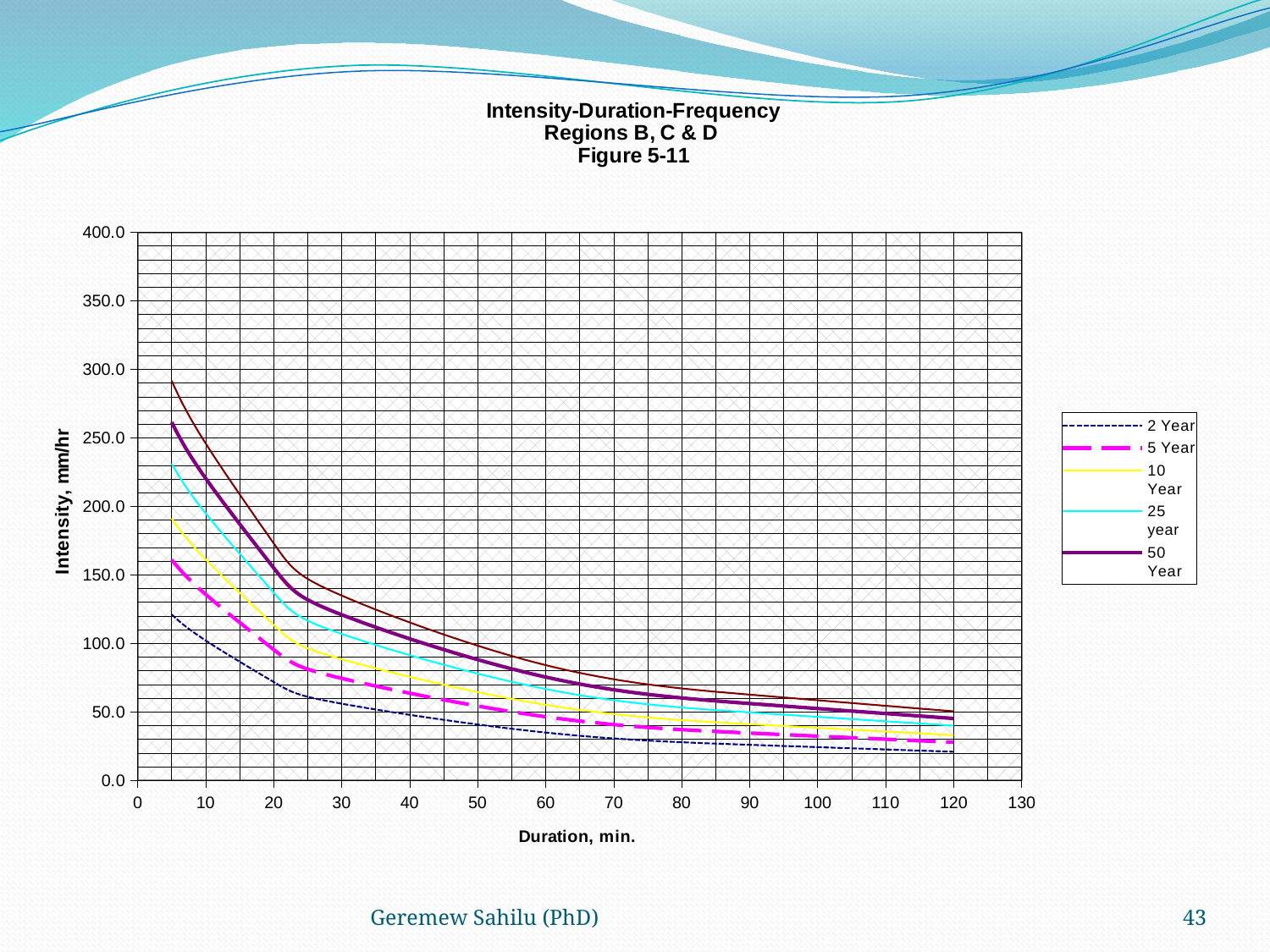
At a duration of 5 min, which is larger: the 50 Year series or the 2 Year series? 50 Year Is the value for the 5 Year series at a duration of 120 min greater or less than 50? less Is the value for the 25 year series at a duration of 5 min greater or less than 200? greater What kind of chart is shown on the slide? line chart Do the intensity values rise or fall as duration increases along the x axis? fall Is the value for the 50 Year series at a duration of 5 min greater or less than 200? greater What is the label of the y axis? Intensity, mm/hr How many series does the legend list? 5 What is the title of the chart? Intensity-Duration-Frequency Regions B, C & D Figure 5-11